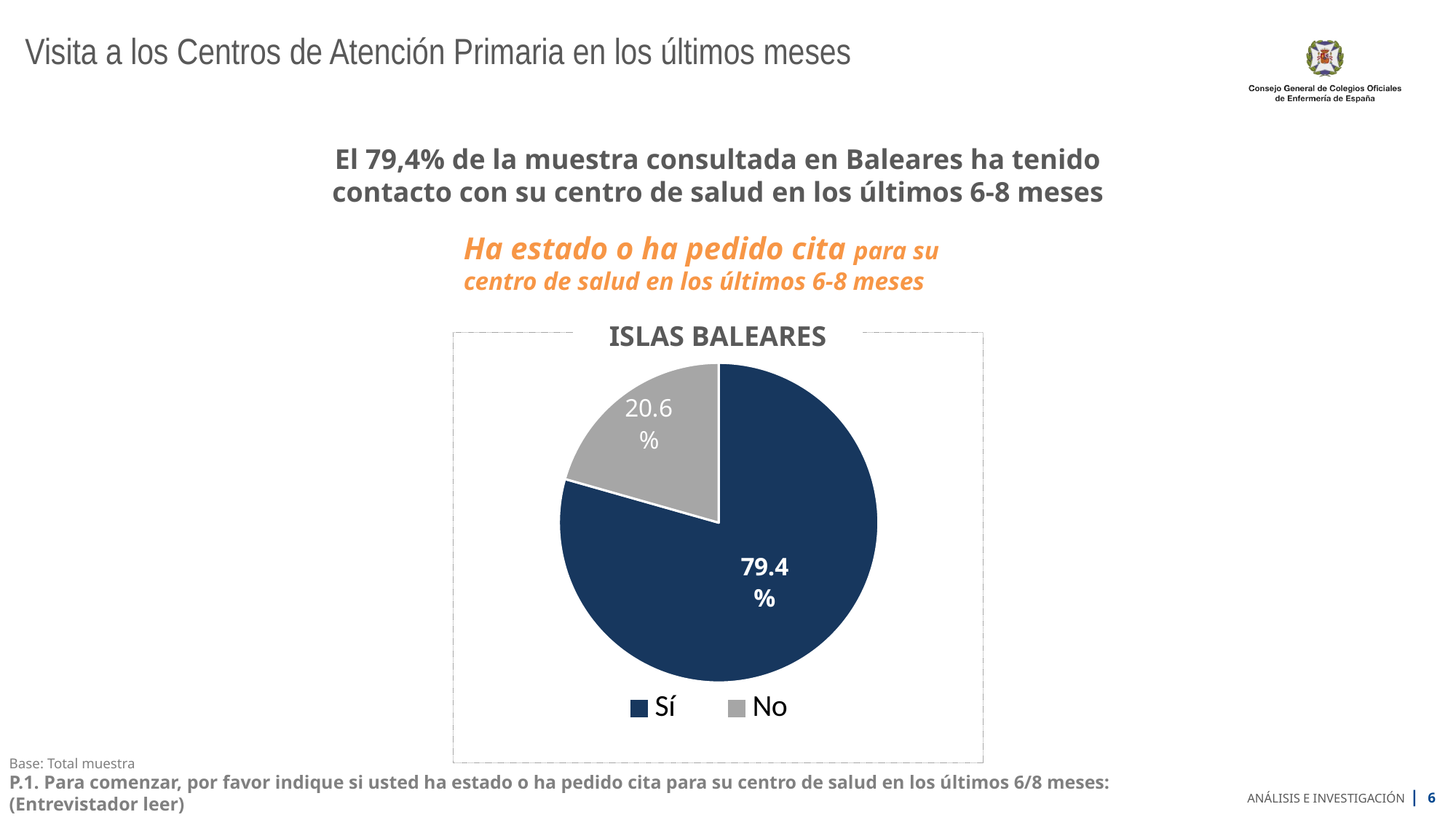
Which slice is the largest in the pie chart? Sí How many slices does the pie chart have? 2 What share of the pie does the "Sí" slice represent? 79.4% Which slice is the smallest in the pie chart? No What is the difference in percentage points between the "Sí" and "No" slices? 58.8 How many entries does the legend list? 2 What percentage of the pie corresponds to "Sí"? 79.4% What kind of chart is shown on the slide? pie chart Which is larger, the "Sí" slice or the "No" slice? Sí What colour is the "No" slice in the pie chart? grey What percentage of the pie corresponds to "No"? 20.6% What is the title of the chart? ISLAS BALEARES